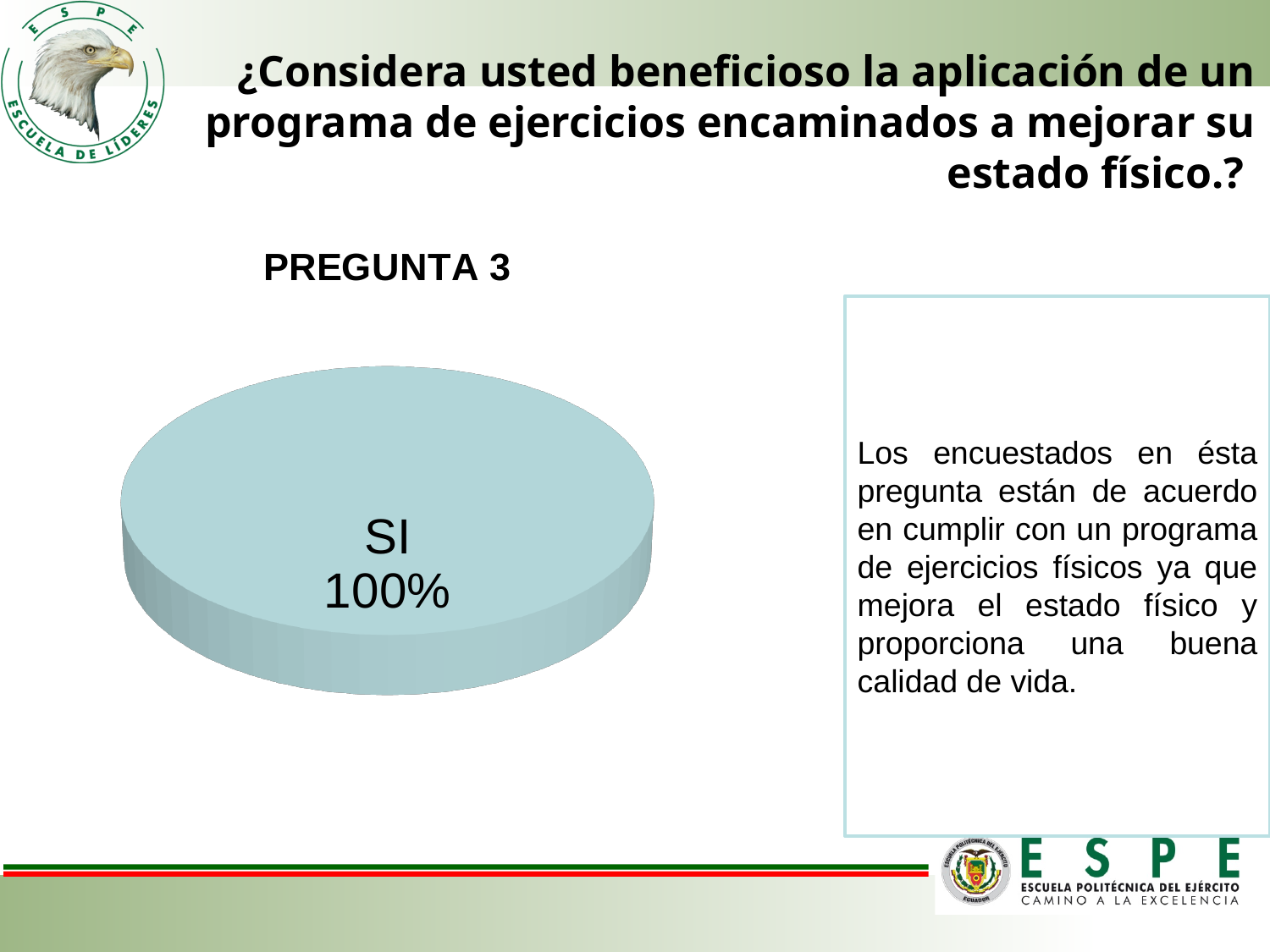
What colour is the pie chart slice? light blue What share of the pie does the "SI" slice represent? 100% What kind of chart is shown on the slide? pie chart What is the value shown for the "SI" category in the pie chart? 100% How many slices does the pie chart have? 1 What label appears above the pie chart? PREGUNTA 3 Which category is the largest in the pie chart? SI Is the value for "SI" greater or less than 50%? greater